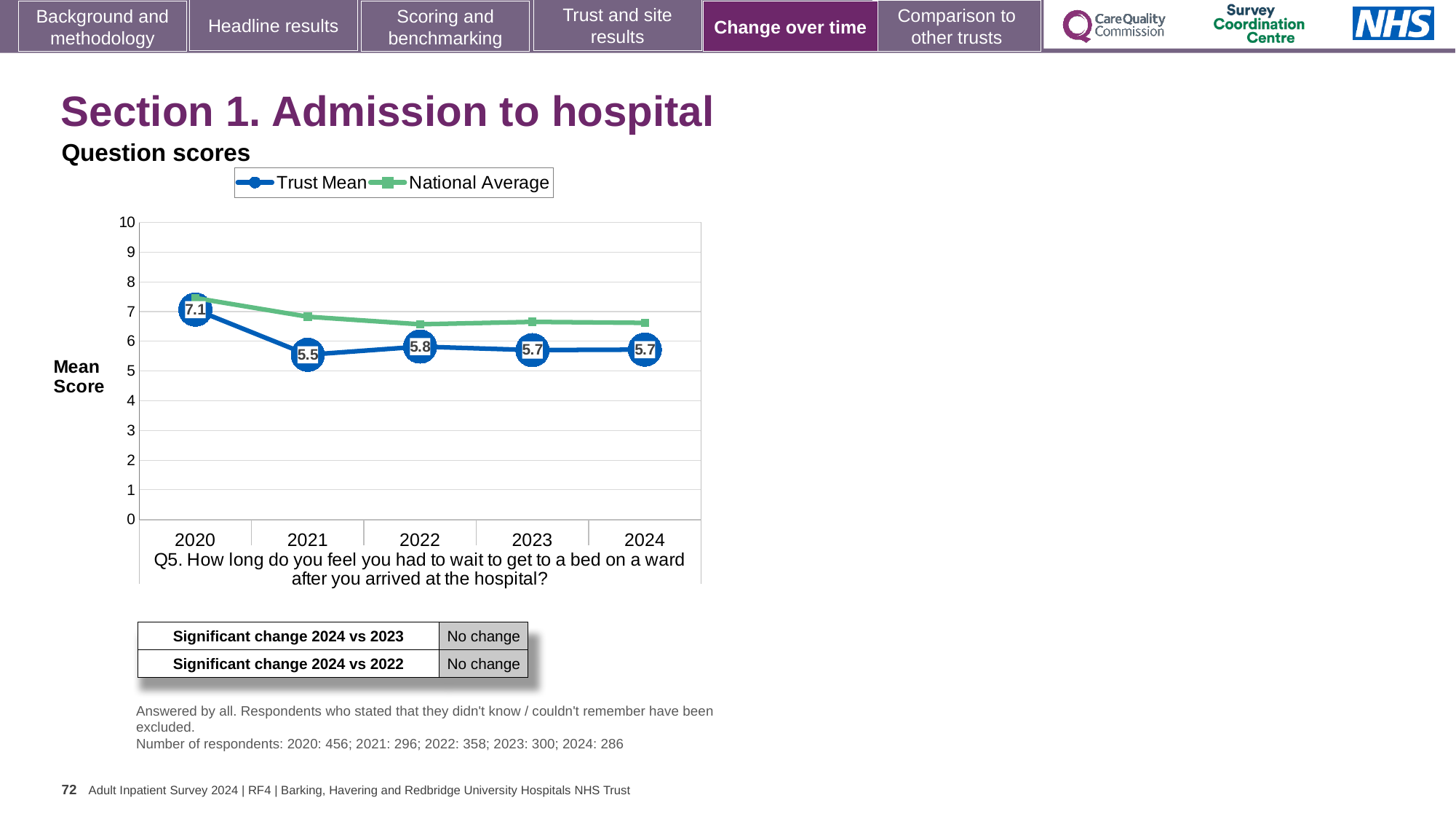
How many years are shown on the x axis of the chart? 5 Which is larger, the Trust Mean score for 2022 or for 2021? 2022 What is the Trust Mean score for 2021? 5.5 What kind of chart is shown on the slide? Line chart In which year is the Trust Mean score highest? 2020 What is the Trust Mean score for 2024? 5.7 Is the National Average value for 2023 greater or less than 7? less Is the National Average value for 2020 greater or less than 7? greater What is the difference between the Trust Mean scores for 2020 and 2021? 1.6 How many series does the chart legend list? 2 What is the Trust Mean score for 2020? 7.1 In which year is the Trust Mean score lowest? 2021